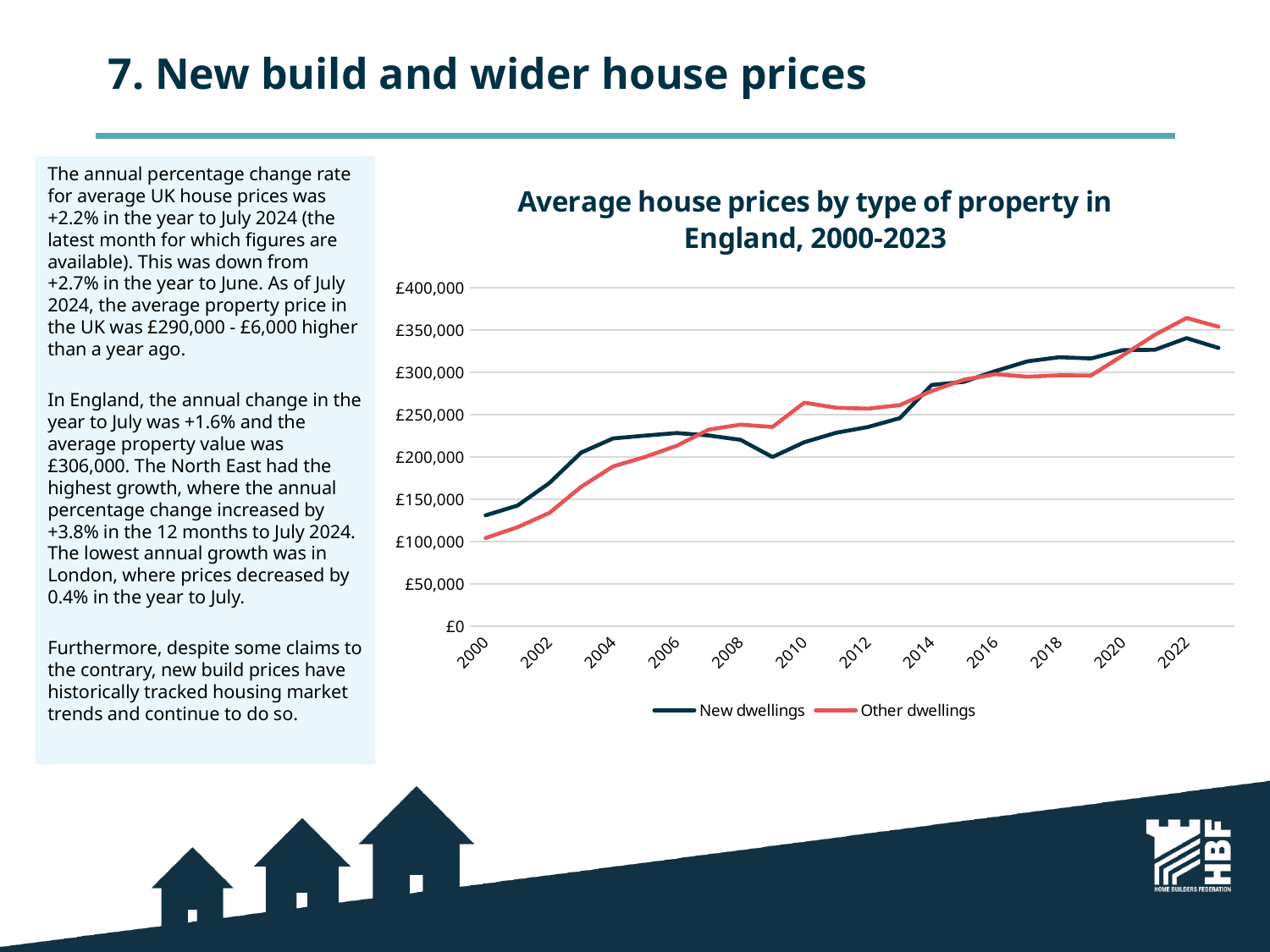
In 2022, which series has the higher value: New dwellings or Other dwellings? Other dwellings Is the value for New dwellings in 2022 greater or less than £350,000? less How many series does the chart legend list? 2 What kind of chart is shown on the slide? Line chart Which series is drawn in red on the chart? Other dwellings Do average house prices for New dwellings generally rise or fall from 2000 to 2022? Rise Is the value for Other dwellings in 2004 greater or less than £200,000? less Is the value for Other dwellings in 2022 greater or less than £350,000? greater In 2000, which series has the higher value: New dwellings or Other dwellings? New dwellings How many year labels are shown on the x axis? 12 What is the title of the chart? Average house prices by type of property in England, 2000-2023